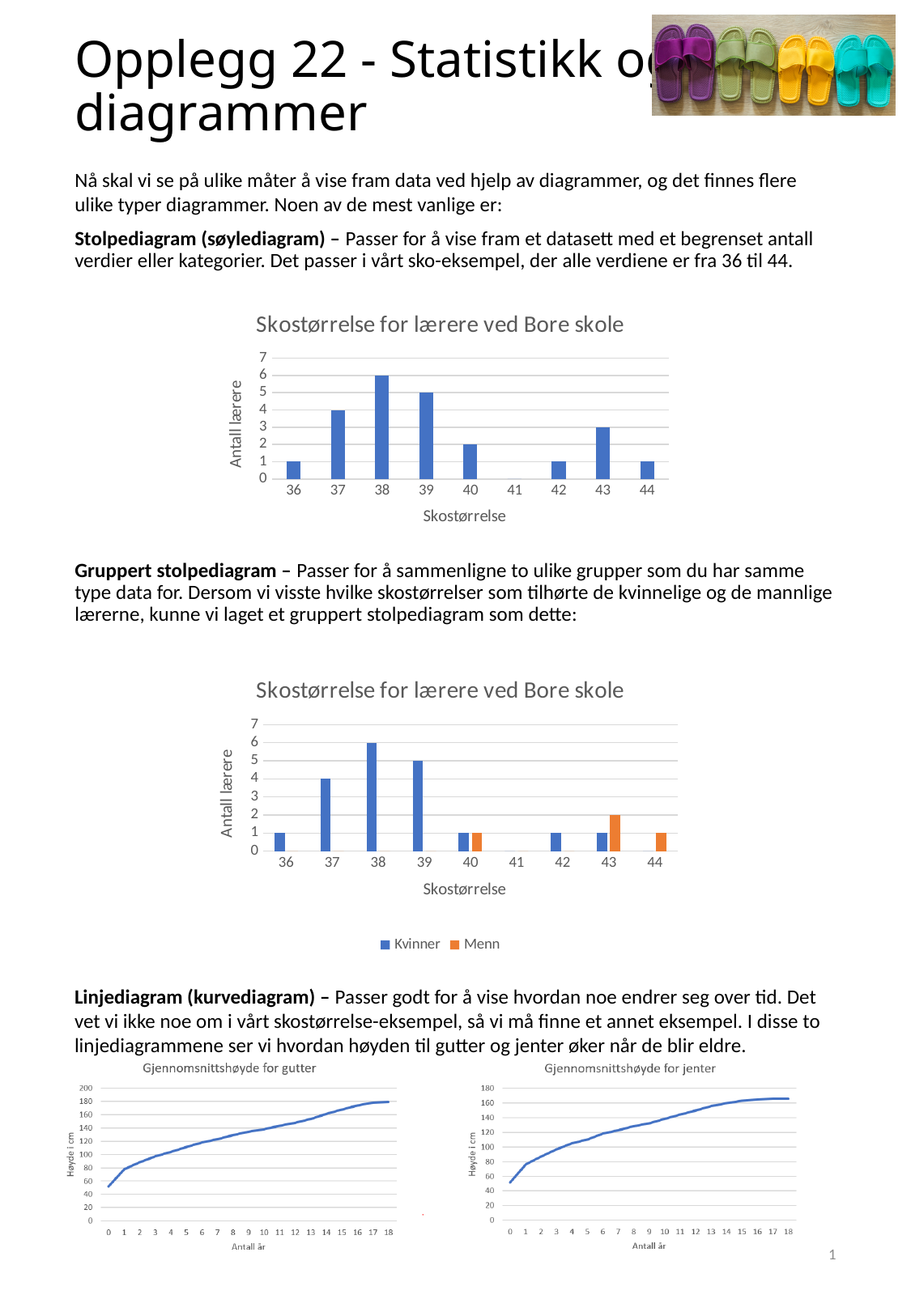
In the grouped bar chart 'Skostørrelse for lærere ved Bore skole', what colour represents Menn? Orange In the top bar chart 'Skostørrelse for lærere ved Bore skole', how many teachers have shoe size 38? 6 In the top bar chart 'Skostørrelse for lærere ved Bore skole', how many shoe size categories are shown on the x axis? 9 In the top bar chart 'Skostørrelse for lærere ved Bore skole', what is the difference between the number of teachers with size 39 and size 40? 3 In the chart 'Gjennomsnittshøyde for jenter', is the value at 5 years greater or less than 100? greater In the grouped bar chart 'Skostørrelse for lærere ved Bore skole', which is larger at size 43: Kvinner or Menn? Menn In the top bar chart 'Skostørrelse for lærere ved Bore skole', how many teachers have shoe size 43? 3 In the top bar chart 'Skostørrelse for lærere ved Bore skole', which shoe size has the most teachers? 38 In the chart 'Gjennomsnittshøyde for jenter', do the values rise or fall as Antall år increases? Rise In the grouped bar chart 'Skostørrelse for lærere ved Bore skole', how many series does the legend list? 2 In the grouped bar chart 'Skostørrelse for lærere ved Bore skole', how many Menn have shoe size 43? 2 What kind of chart is 'Gjennomsnittshøyde for gutter'? Line chart